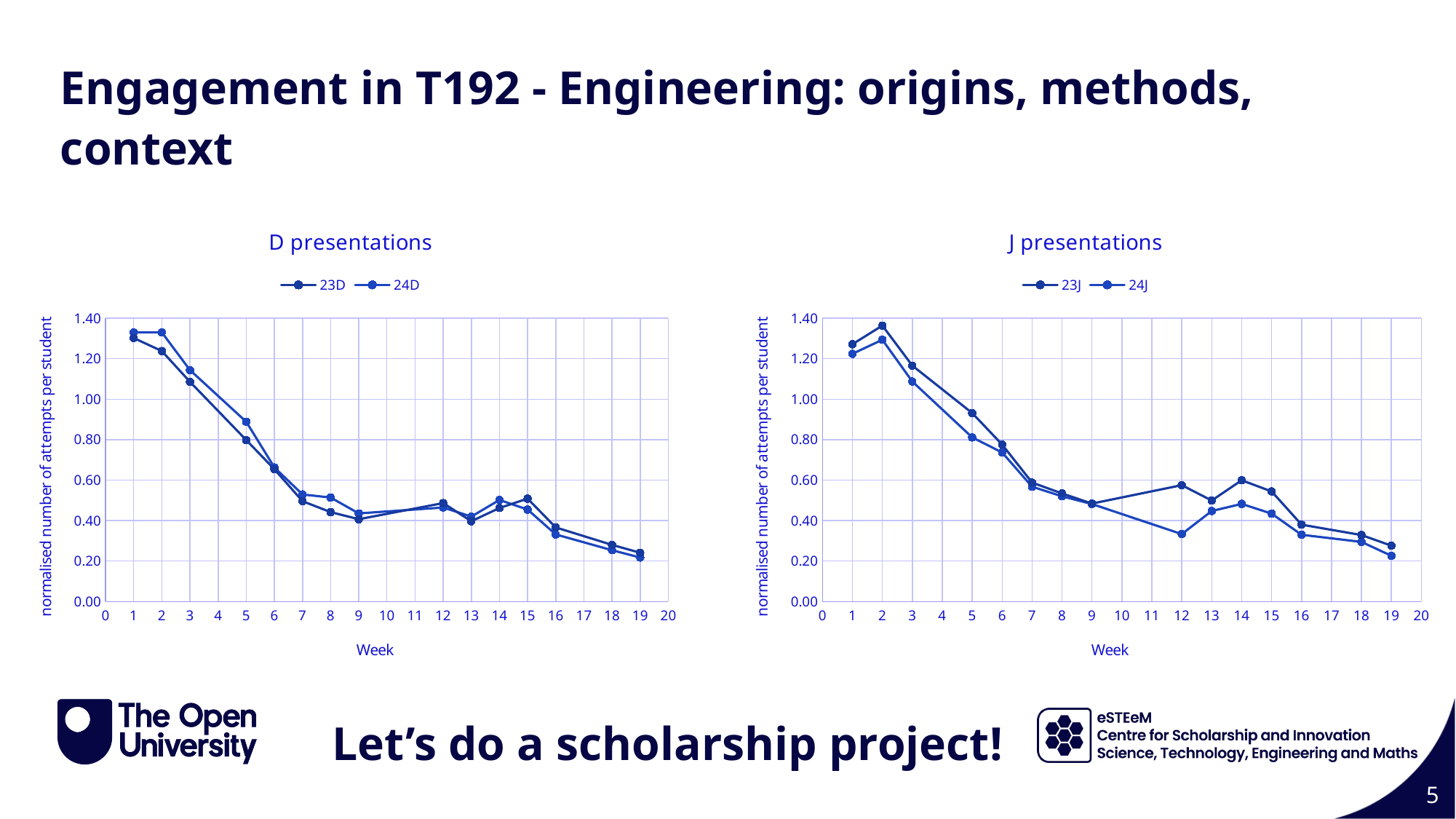
In the 'J presentations' chart, which series has the larger value at week 12, 23J or 24J? 23J What are the two series named in the legend of the 'D presentations' chart? 23D and 24D What is the label of the y axis on the 'D presentations' chart? normalised number of attempts per student In the 'J presentations' chart, do the values for 24J generally rise or fall from week 2 to week 19? fall In the 'J presentations' chart, is the value for 23J at week 2 greater or less than 1.20? greater In the 'J presentations' chart, is the value for 24J at week 19 greater or less than 0.40? less In the 'D presentations' chart, is the value for 24D at week 5 greater or less than 0.80? greater What kind of chart is the 'D presentations' chart? line chart How many series does the legend of the 'J presentations' chart list? 2 In the 'J presentations' chart, at which week does 23J reach its highest value? Week 2 In the 'D presentations' chart, do the values for 23D generally rise or fall as the week number increases? fall